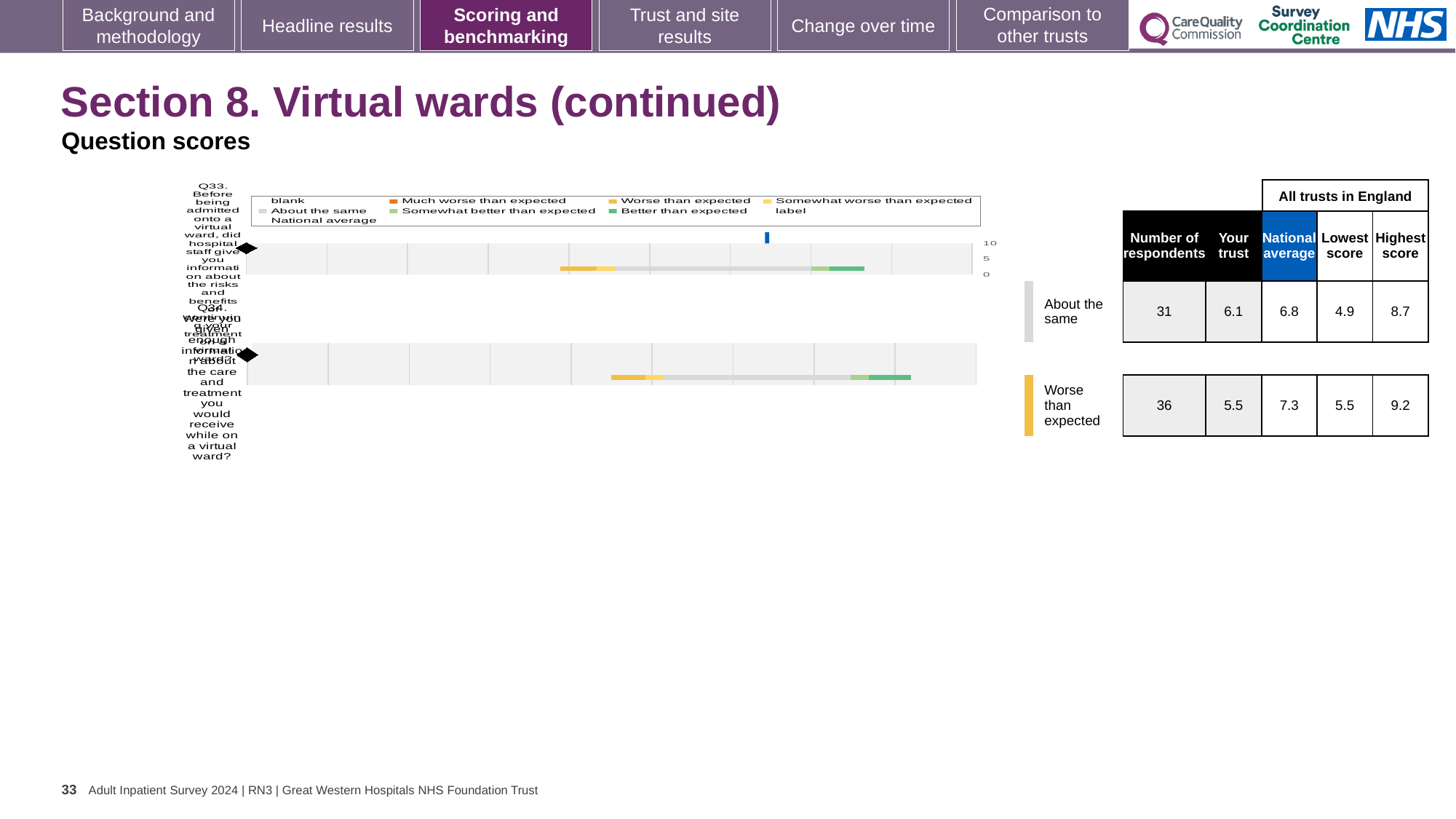
What is the highest score listed for the second row (Q34, Worse than expected)? 9.2 What benchmark rating is shown for the second row (Q34)? Worse than expected In the table next to the chart, what is the 'Your trust' score for the first row (Q33, About the same)? 6.1 How many respondents are listed for the first row (Q33, About the same)? 31 Which row has the higher 'Your trust' score, Q33 or Q34? Q33 In the table next to the chart, what is the national average for the second row (Q34, Worse than expected)? 7.3 Which row has more respondents, Q33 (About the same) or Q34 (Worse than expected)? Q34 (Worse than expected) How many questions (rows) are plotted in the chart? 2 By how much does the national average exceed the 'Your trust' score for the first row (Q33, About the same)? 0.7 What is the lowest score listed for the first row (Q33, About the same)? 4.9 What colour does the legend use for 'Better than expected'? green What kind of chart is shown on the slide? bar chart